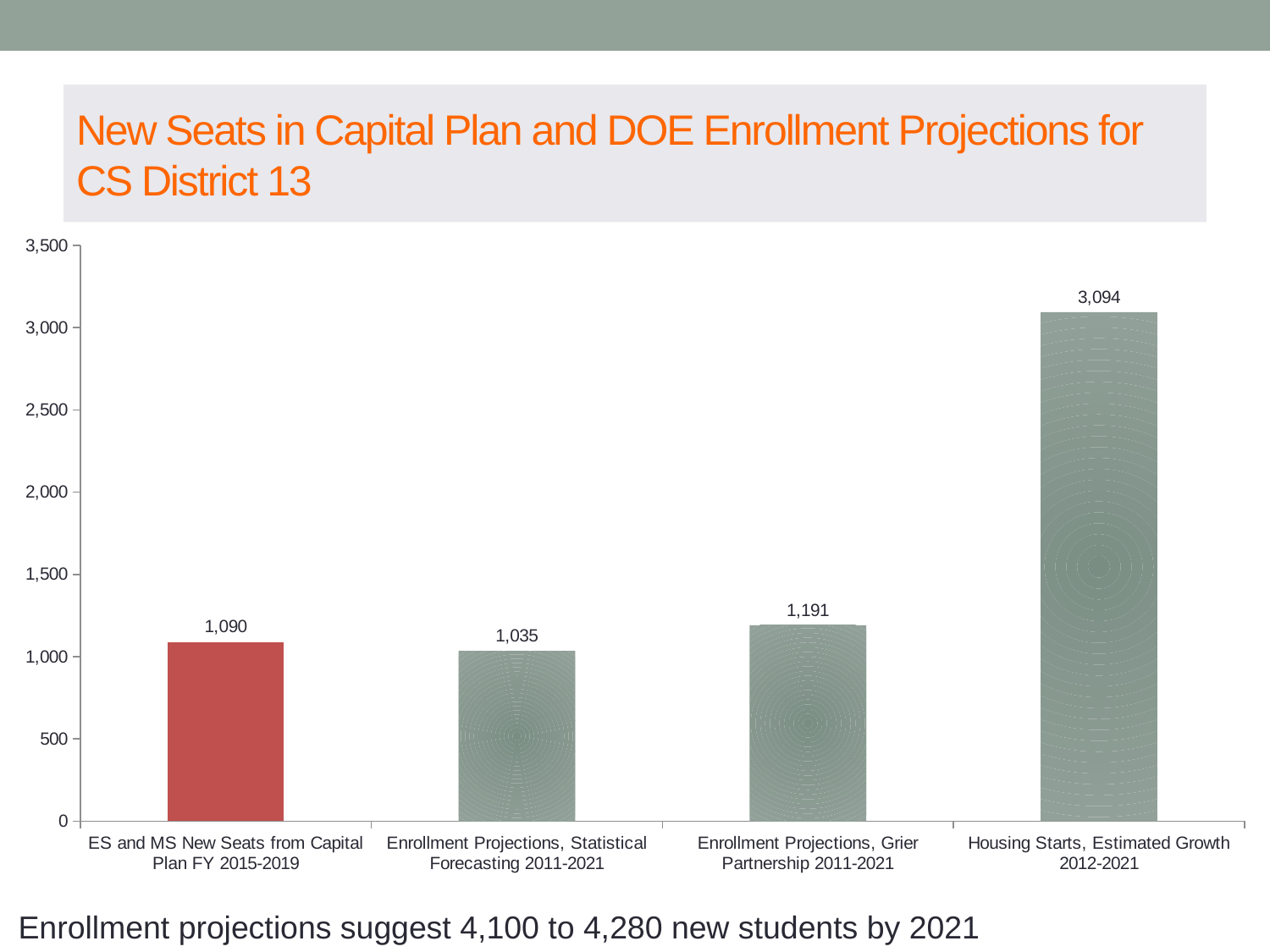
How many categories are shown on the chart? 4 What is the value for Enrollment Projections, Statistical Forecasting 2011-2021? 1,035 What is the value for Enrollment Projections, Grier Partnership 2011-2021? 1,191 What is the difference between the Housing Starts, Estimated Growth 2012-2021 value and the ES and MS New Seats from Capital Plan FY 2015-2019 value? 2,004 Which is larger: the value for Enrollment Projections, Grier Partnership 2011-2021 or the value for ES and MS New Seats from Capital Plan FY 2015-2019? Enrollment Projections, Grier Partnership 2011-2021 Is the value for Housing Starts, Estimated Growth 2012-2021 greater or less than 3,000? greater What is the value for Housing Starts, Estimated Growth 2012-2021? 3,094 Which category has the highest value? Housing Starts, Estimated Growth 2012-2021 What is the difference between the Grier Partnership projection and the Statistical Forecasting projection? 156 What is the value for ES and MS New Seats from Capital Plan FY 2015-2019? 1,090 What kind of chart is shown on the slide? bar chart Which category has the lowest value? Enrollment Projections, Statistical Forecasting 2011-2021